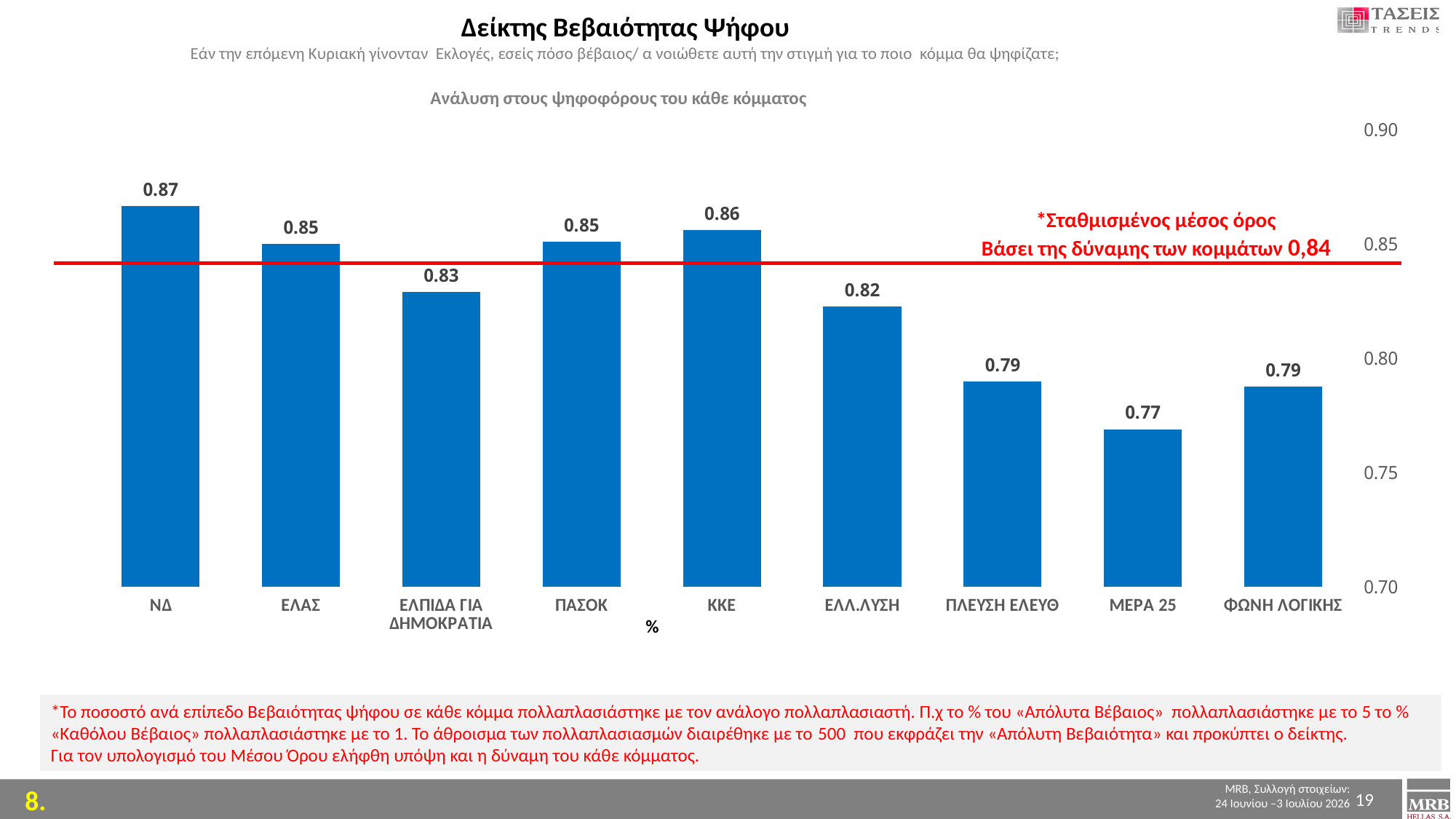
What weighted average value is indicated by the red line on the chart? 0,84 What is the value for ΕΛΠΙΔΑ ΓΙΑ ΔΗΜΟΚΡΑΤΙΑ? 0.83 What is the difference between the values for ΝΔ and ΜΕΡΑ 25? 0.10 What is the value for ΜΕΡΑ 25? 0.77 Which party has the lowest value? ΜΕΡΑ 25 What is the value for ΚΚΕ? 0.86 What is the value for ΝΔ? 0.87 Which party has the highest value? ΝΔ Which is larger, the value for ΚΚΕ or the value for ΕΛΛ.ΛΥΣΗ? ΚΚΕ How many parties are shown on the chart? 9 Is the value for ΠΛΕΥΣΗ ΕΛΕΥΘ greater or less than 0.80? less What kind of chart is shown on the slide? bar chart